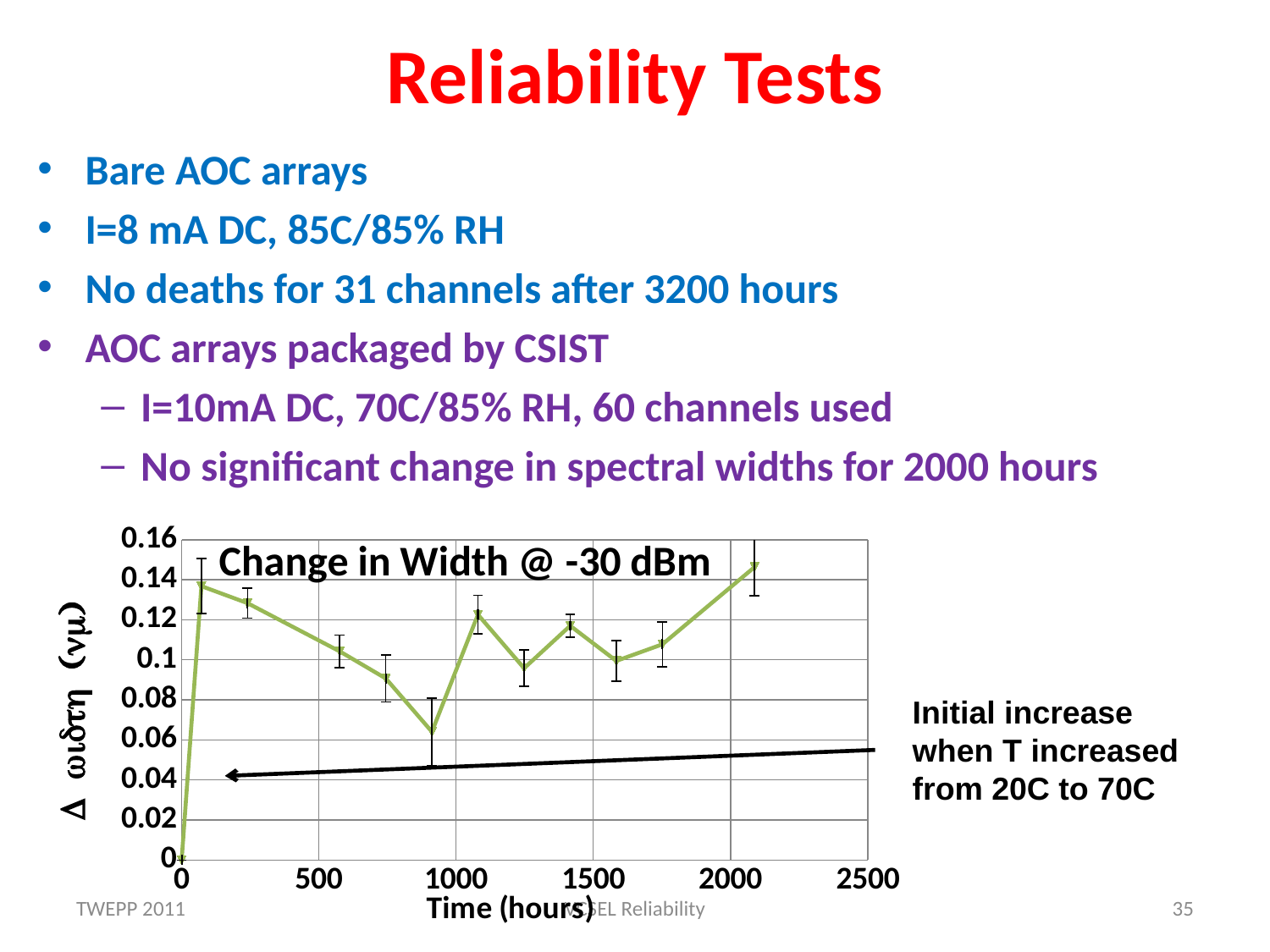
Is the value of the lowest point after the start (around 900 hours) greater or less than 0.08? less How many data points are plotted on the line? 12 What is the plotted value at time 0 hours? 0 What kind of chart is shown on the slide? line chart Is the value of the point at about 1250 hours greater or less than 0.12? less What is the title of the chart? Change in Width @ -30 dBm What is the label of the x axis of the chart? Time (hours) Which is larger: the value at about 900 hours or the value at about 1100 hours? the value at about 1100 hours Does the plotted value rise or fall between 0 hours and the first measurement at about 70 hours? rise Does the plotted value rise or fall between about 250 hours and about 900 hours? fall Is the value of the last plotted point (around 2100 hours) greater or less than 0.12? greater What is the highest value shown on the y axis of the chart? 0.16